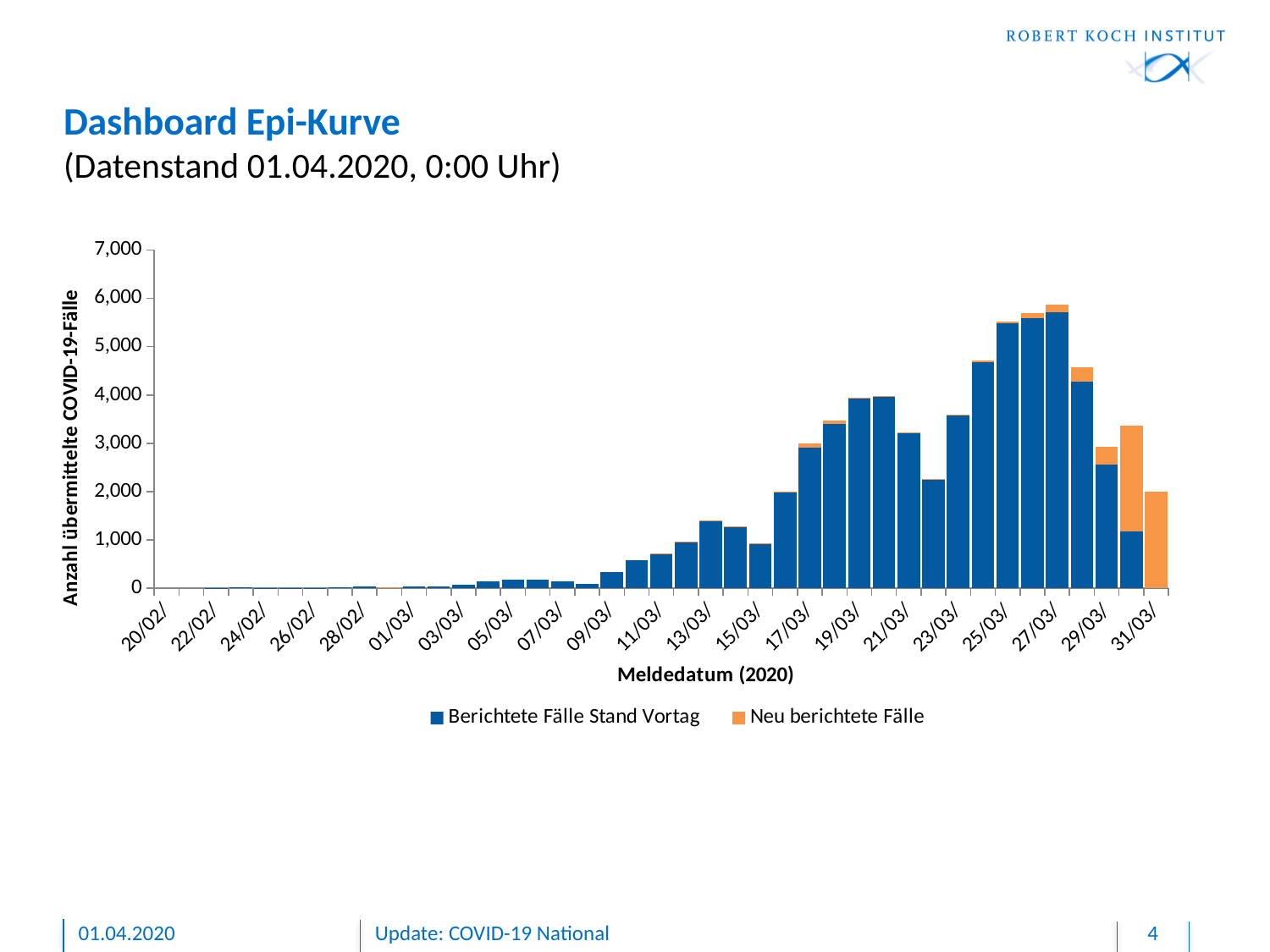
Is the total value for 23/03 greater or less than 4,000? less Is the total value for 25/03 greater or less than 5,000? greater Is the total value for 15/03 greater or less than 1,000? less What kind of chart is shown on the slide? Stacked bar chart What are the two series named in the legend? Berichtete Fälle Stand Vortag; Neu berichtete Fälle Do the total values rise or fall from 22/03 to 27/03? rise How many series does the legend list? 2 Which has the larger 'Berichtete Fälle Stand Vortag' value, 30/03 or 31/03? 30/03 What is the label of the y axis? Anzahl übermittelte COVID-19-Fälle Which has the larger total, 25/03 or 21/03? 25/03